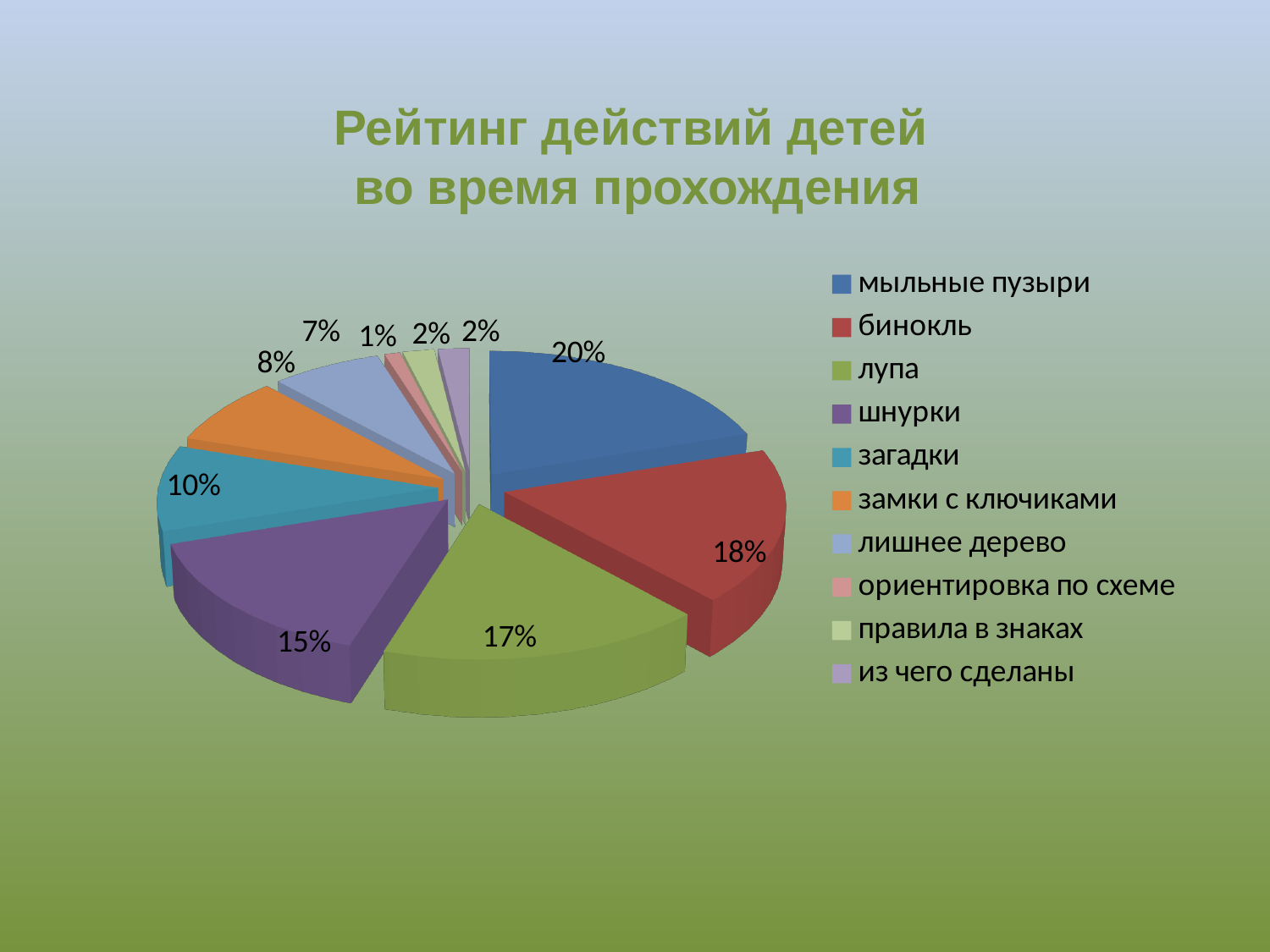
Which is larger, the share of 'бинокль' or the share of 'шнурки'? бинокль What share of the pie is 'загадки'? 10% What share of the pie is 'шнурки'? 15% Which category has the smallest share of the pie? ориентировка по схеме What is the difference between the shares of 'лупа' and 'замки с ключиками'? 9% Which category has the largest share of the pie? мыльные пузыри What is the title of the chart? Рейтинг действий детей во время прохождения What share of the pie is 'лишнее дерево'? 7% What type of chart is shown on the slide? pie chart How many categories does the legend list? 10